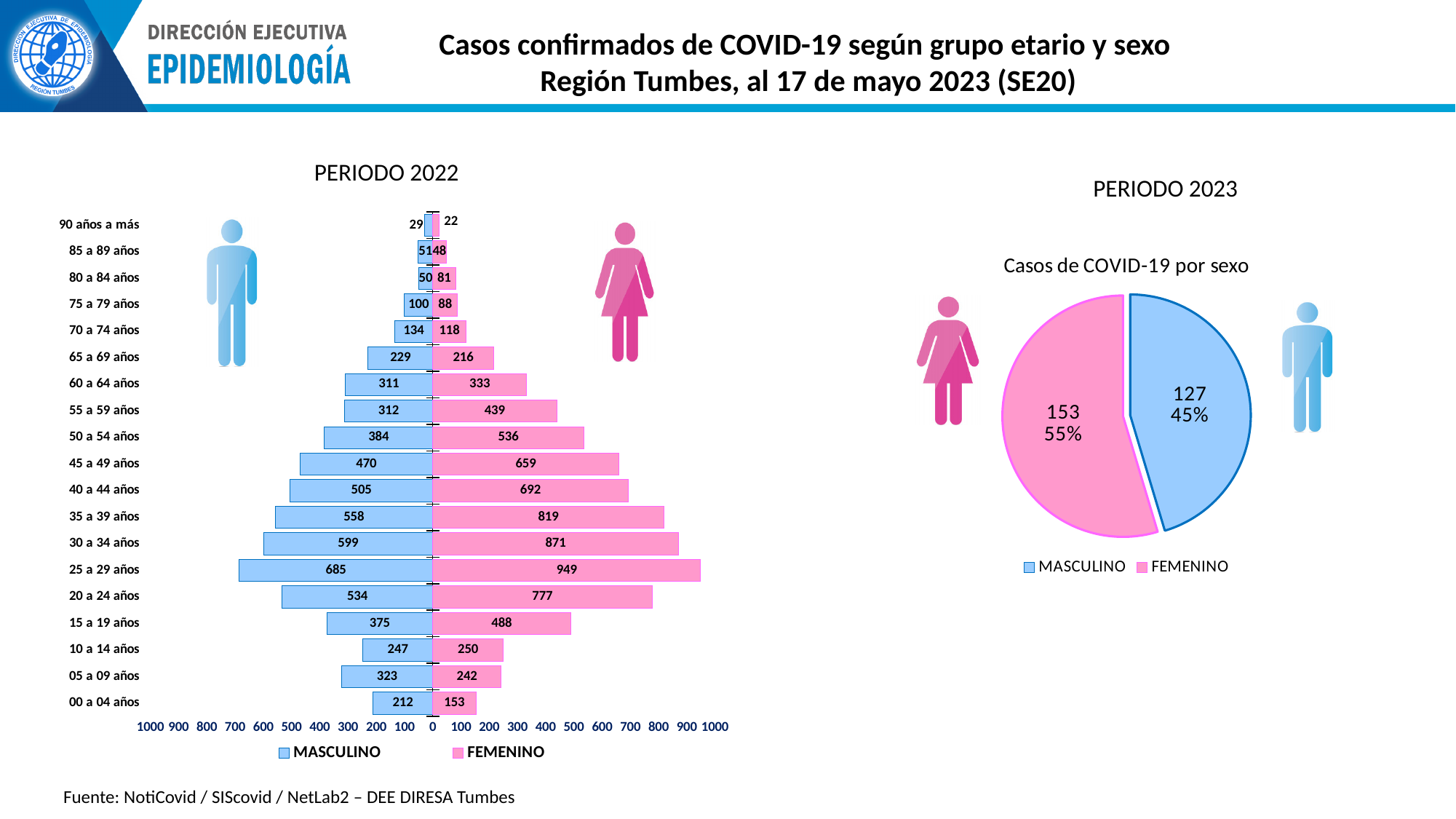
In the PERIODO 2022 chart, what is the difference between the FEMENINO and MASCULINO values for the 30 a 34 años group? 272 In the PERIODO 2023 pie chart, what is the MASCULINO value? 127 In the PERIODO 2022 chart, which age group has the highest MASCULINO value? 25 a 29 años How many age groups are shown in the PERIODO 2022 chart? 19 In the PERIODO 2022 chart, which is larger for the 05 a 09 años group, MASCULINO or FEMENINO? MASCULINO In the PERIODO 2022 chart, which age group has the lowest FEMENINO value? 90 años a más In the PERIODO 2023 pie chart, what share of cases is FEMENINO? 55% In the PERIODO 2023 pie chart, what is the total of the MASCULINO and FEMENINO values? 280 What kind of chart is the PERIODO 2022 chart? Bar chart In the PERIODO 2022 chart, what is the MASCULINO value for the 45 a 49 años group? 470 In the PERIODO 2022 chart, what is the FEMENINO value for the 25 a 29 años group? 949 How many series does the legend of the PERIODO 2022 chart list? 2